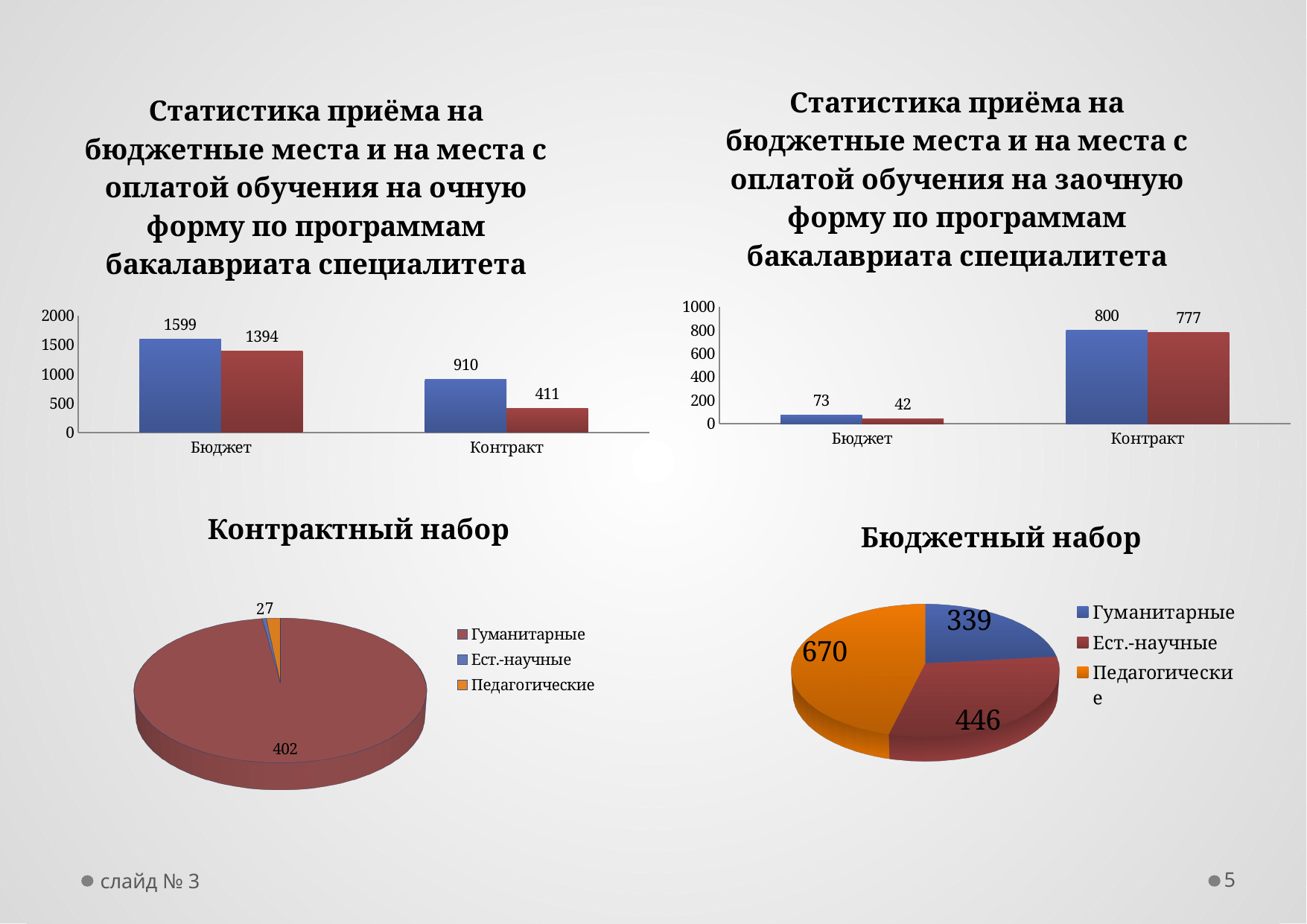
In the top-right bar chart (заочную форму), which category has the higher blue bar, Бюджет or Контракт? Контракт In the top-left bar chart (очную форму), what is the value of the red bar for Контракт? 411 In the pie chart titled 'Бюджетный набор', which category has the smallest slice? Гуманитарные In the pie chart titled 'Контрактный набор', what is the value for Педагогические? 7 In the top-right bar chart (заочную форму), what is the value of the red bar for Бюджет? 42 How many entries does the legend of the pie chart titled 'Контрактный набор' list? 3 In the pie chart titled 'Бюджетный набор', what is the value for Педагогические? 670 In the top-left bar chart (очную форму), what is the difference between the blue and red bars for Бюджет? 205 How many categories are shown on the x axis of the top-right bar chart (заочную форму)? 2 What kind of chart is the top-left chart (очную форму)? bar chart In the top-right bar chart (заочную форму), what is the value of the blue bar for Контракт? 800 In the top-left bar chart (очную форму), what is the value of the blue bar for Бюджет? 1599